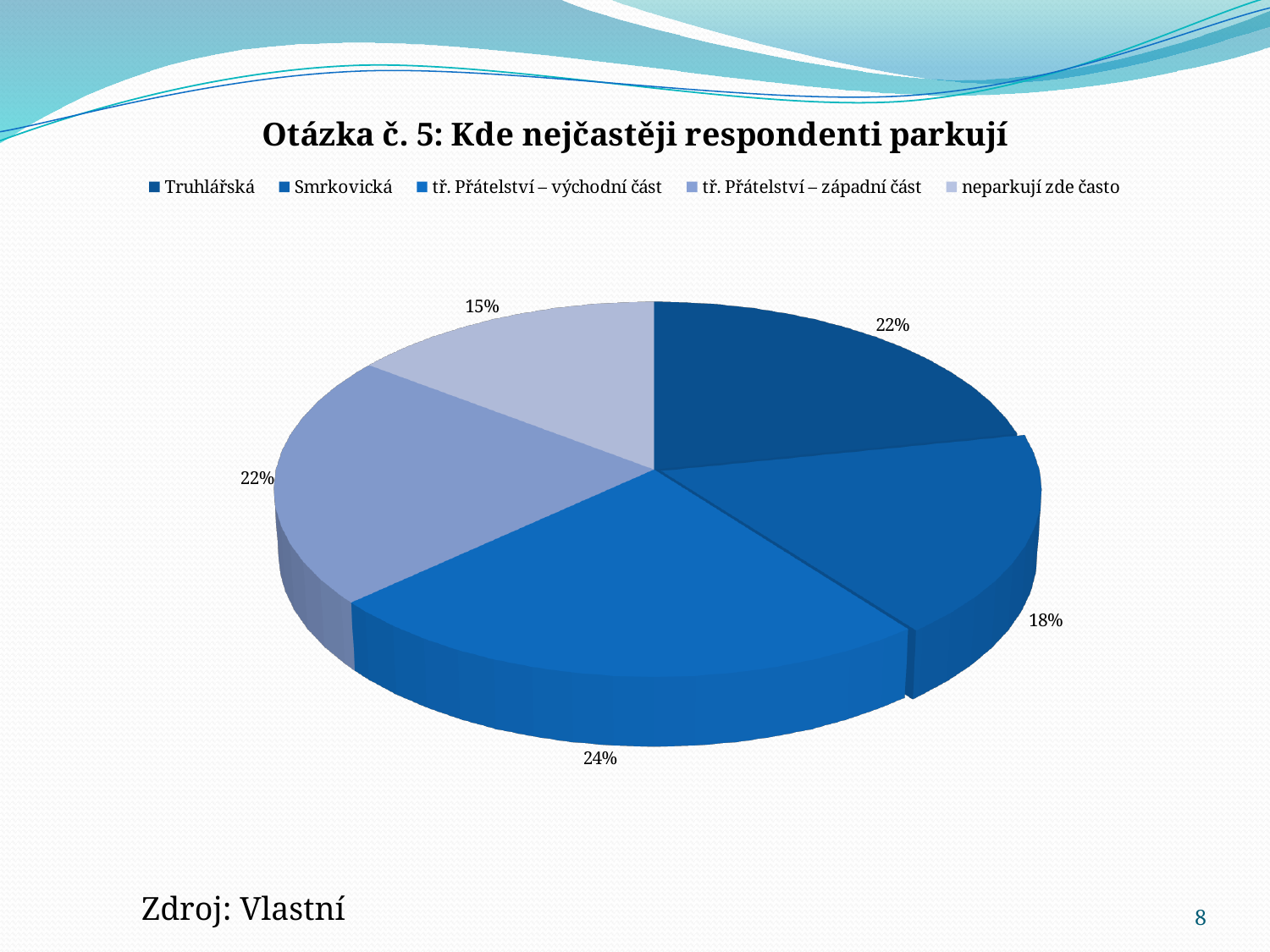
What percentage is shown for neparkují zde často? 15% What is the difference in percentage points between tř. Přátelství – východní část and Smrkovická? 6 How many categories does the pie chart show? 5 Which category has the largest slice of the pie? tř. Přátelství – východní část Which is larger, the slice for Smrkovická or the slice for tř. Přátelství – západní část? tř. Přátelství – západní část What kind of chart is shown on the slide? pie chart What share of respondents does the slice for tř. Přátelství – východní část represent? 24% What is the title of the chart? Otázka č. 5: Kde nejčastěji respondenti parkují What is the difference in percentage points between Truhlářská and neparkují zde často? 7 Which category has the smallest slice of the pie? neparkují zde často What percentage is shown for Smrkovická? 18% What percentage is shown for Truhlářská? 22%